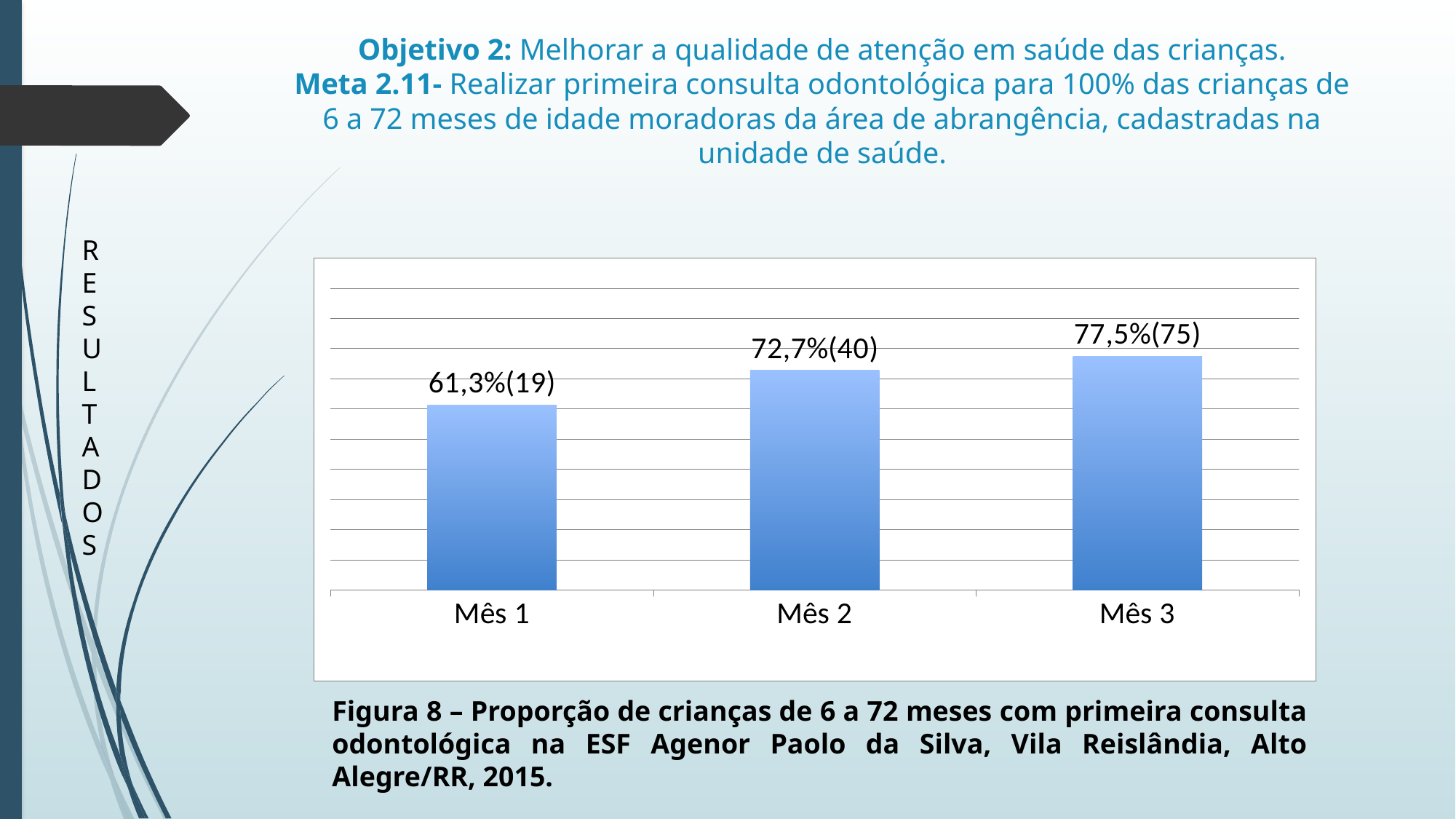
What type of chart is shown on the slide? Bar chart What is the value shown for Mês 1? 61,3%(19) What percentage is shown for Mês 3? 77,5% What number appears in parentheses next to the Mês 3 bar? 75 Which month has the highest proportion? Mês 3 What is the value shown for Mês 2? 72,7%(40) Do the values rise or fall from Mês 1 to Mês 3? Rise How many bars are shown in the chart? 3 Which is larger, the value for Mês 2 or the value for Mês 3? Mês 3 What is the difference in percentage between Mês 2 and Mês 1? 11,4% Which month has the lowest proportion? Mês 1 What is the difference in percentage between Mês 3 and Mês 1? 16,2%